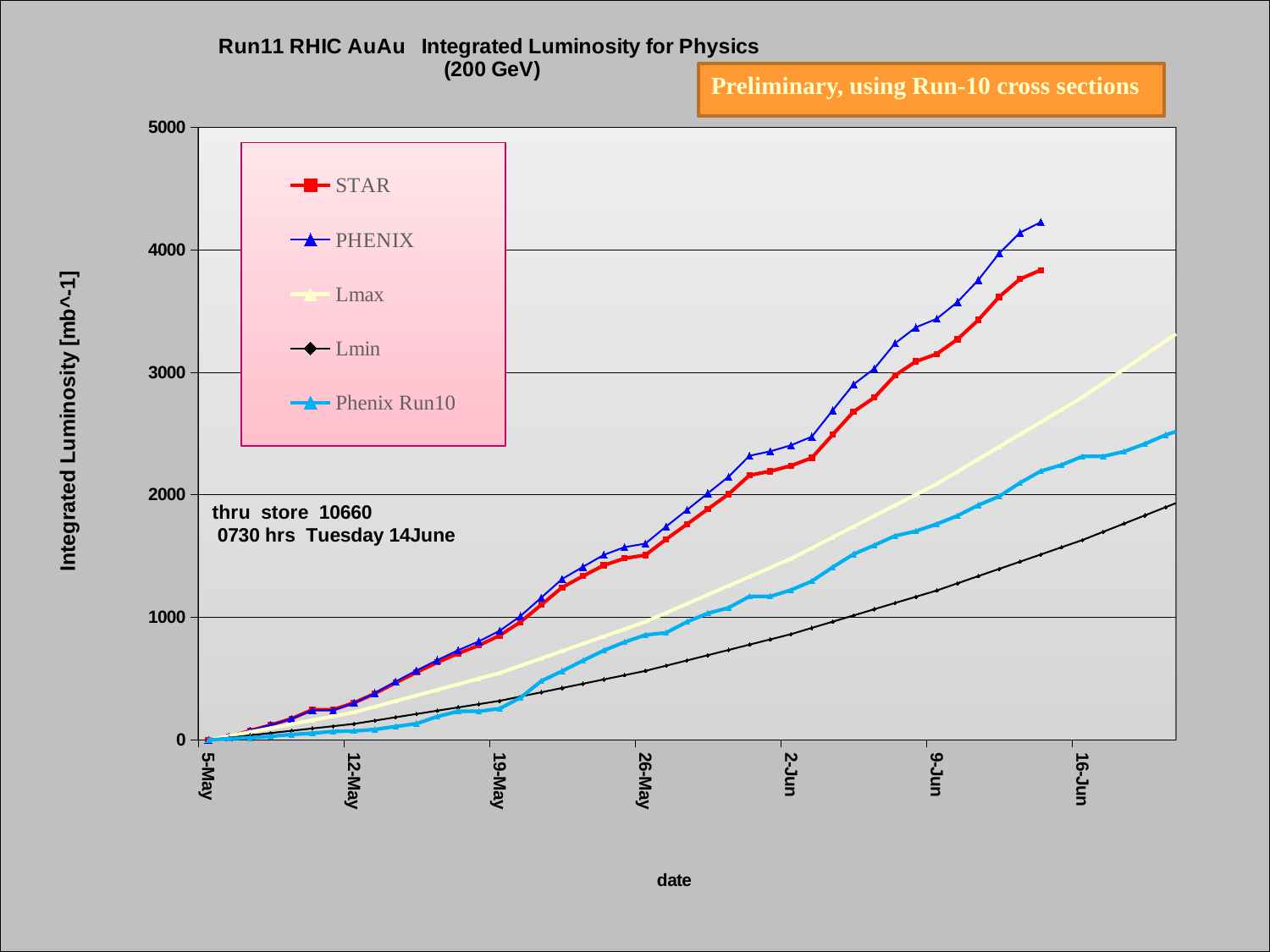
Which series reaches the highest integrated luminosity by the end of the plotted data? PHENIX Is the Lmin value at 16-Jun greater or less than 2000? less Is the PHENIX value at 9-Jun greater or less than 3000? greater Which is larger at 26-May, the Lmax value or the Lmin value? Lmax How many series does the legend list? 5 What is the label of the y axis? Integrated Luminosity [mb^-1] Which series has the lowest integrated luminosity at 16-Jun? Lmin Which is larger at 9-Jun, the PHENIX value or the STAR value? PHENIX Do the integrated luminosity values rise or fall along the date axis? rise Is the Phenix Run10 value at 16-Jun greater or less than 2000? greater What kind of chart is shown on the slide? line chart